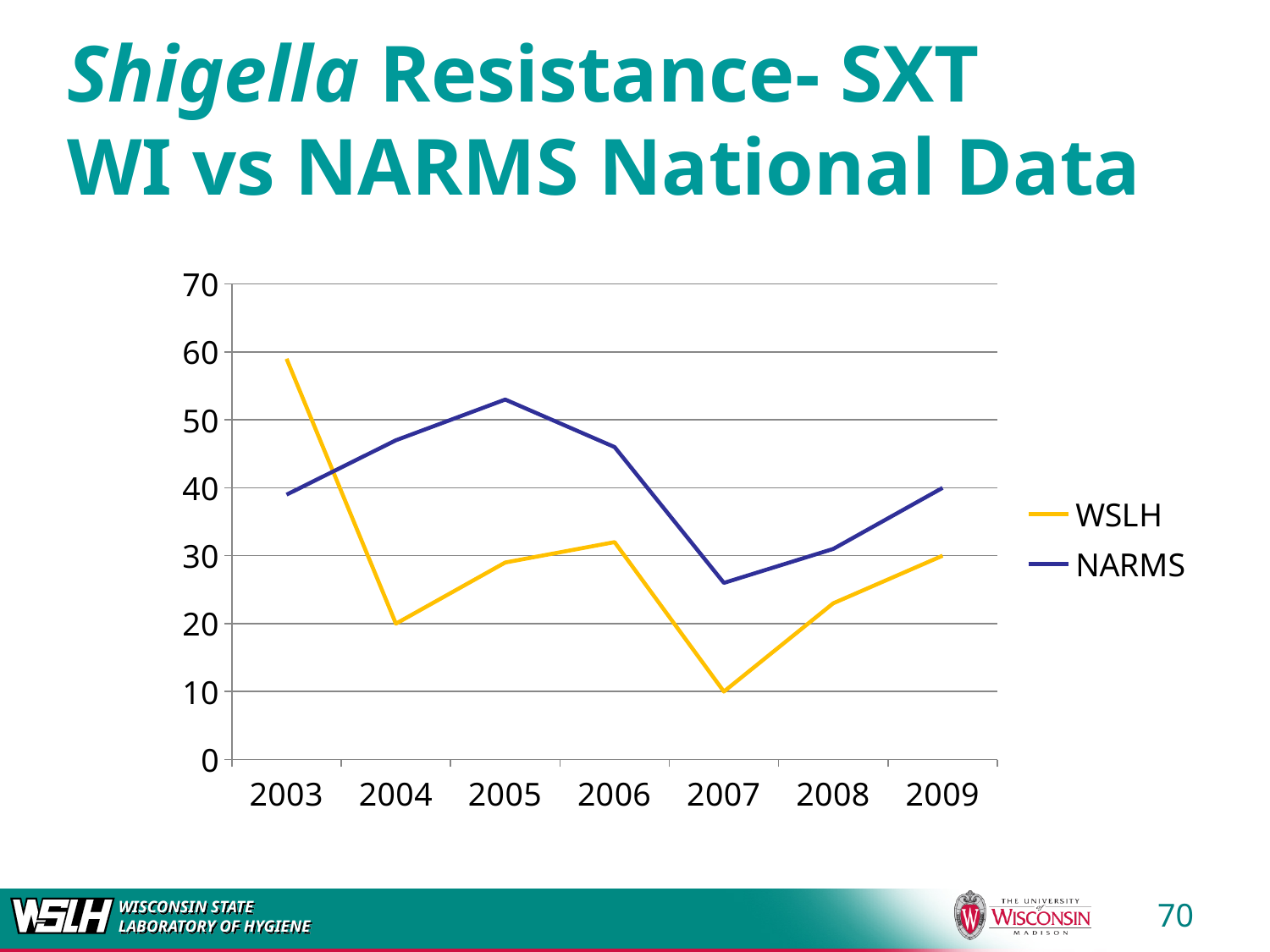
How many years are plotted along the x axis? 7 Is the NARMS value for 2007 greater or less than 30? less How many series does the legend list? 2 Which colour is used for the NARMS line? Blue Is the WSLH value for 2003 greater or less than 50? greater In 2003, which series has the higher value, WSLH or NARMS? WSLH In which year is the WSLH value lowest? 2007 Does the WSLH line rise or fall from 2007 to 2009? Rise What is the WSLH value in 2007? 10 In which year is the NARMS value highest? 2005 What type of chart is shown on the slide? Line chart In which year is the WSLH value highest? 2003